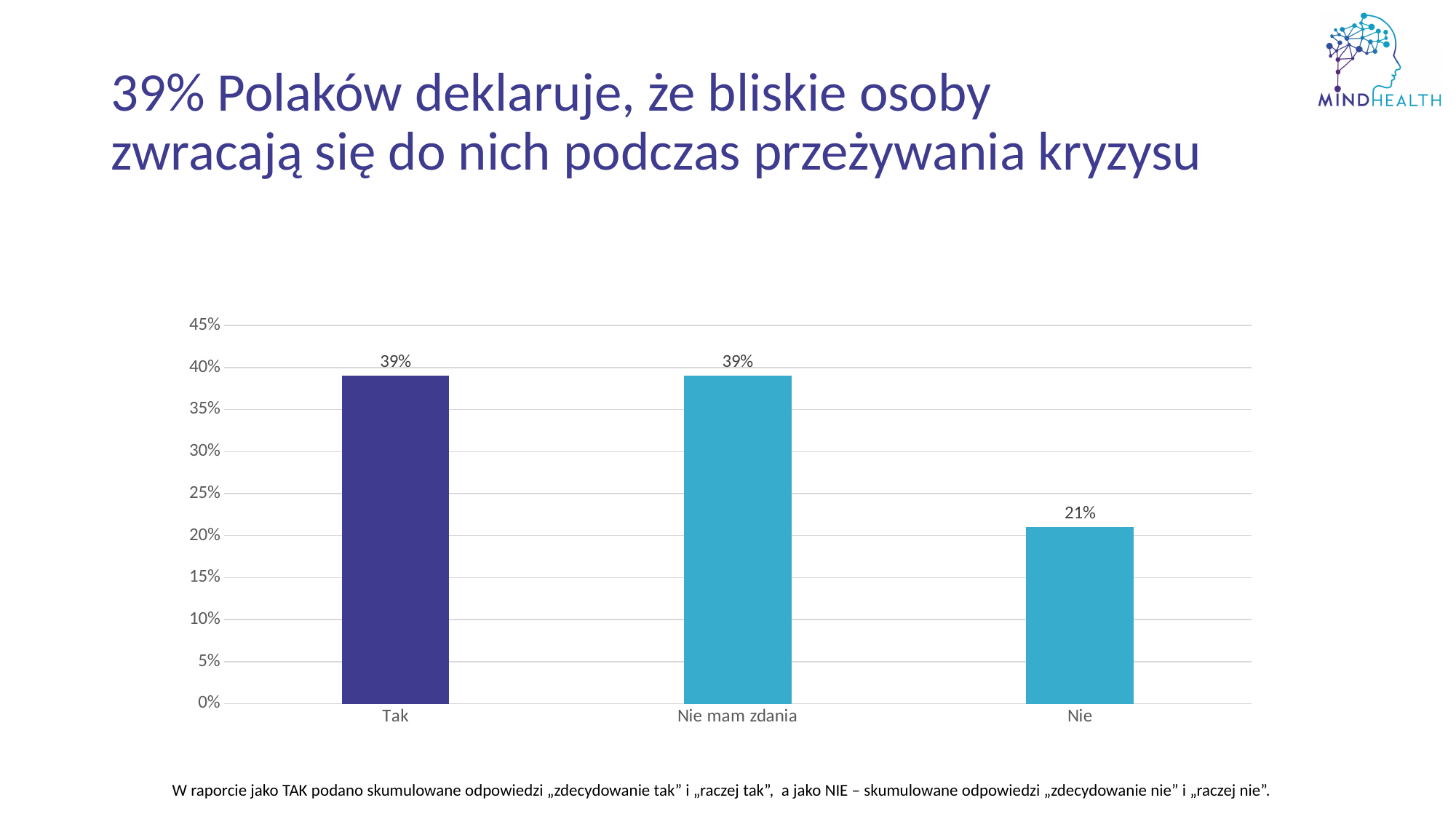
Which category has the lowest value? Nie Which bar is a different colour from the other two? Tak What is the difference between the values for "Tak" and "Nie"? 18% Is the value for "Nie" greater or less than 25%? less What kind of chart is shown on the slide? bar chart Which is larger, the value for "Nie mam zdania" or the value for "Nie"? Nie mam zdania Is the value for "Tak" greater or less than 35%? greater What is the value for "Nie"? 21% What is the highest value shown on the y axis? 45% How many categories are shown on the x axis? 3 What is the value for "Nie mam zdania"? 39% What is the value for "Tak"? 39%